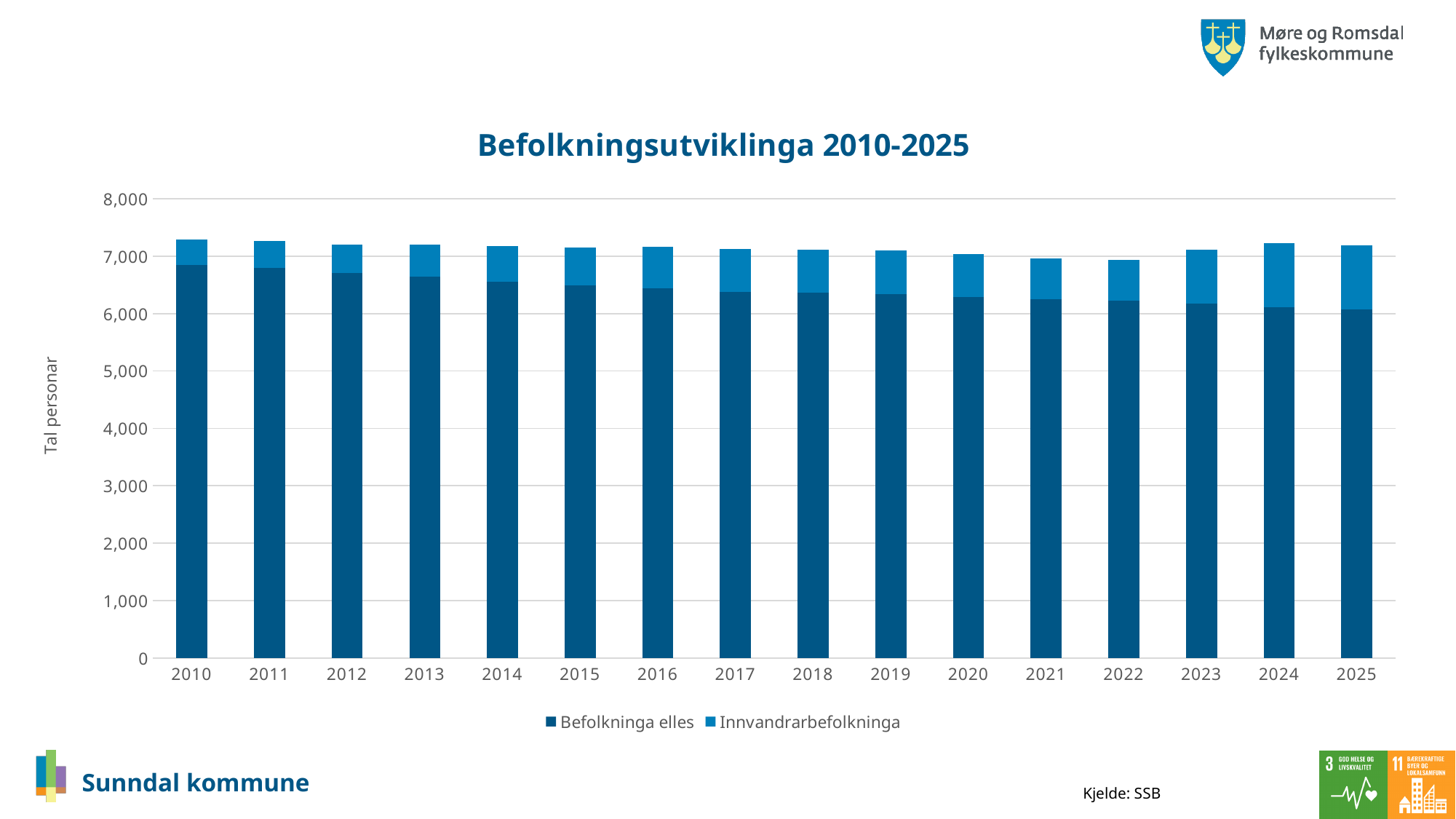
What is the title of the chart? Befolkningsutviklinga 2010-2025 Does the Innvandrarbefolkninga series rise or fall from 2010 to 2025? rise Is the Innvandrarbefolkninga segment for 2010 greater or less than 1,000? less Is the total bar height for 2010 greater or less than 7,000? greater What is the label on the vertical axis? Tal personar Which year has the larger Befolkninga elles value, 2010 or 2025? 2010 Which year has the larger Innvandrarbefolkninga value, 2010 or 2025? 2025 Does the Befolkninga elles series rise or fall from 2010 to 2025? fall How many years are shown along the x axis? 16 Is the value of Befolkninga elles for 2010 greater or less than 6,000? greater How many series does the legend list? 2 What kind of chart is shown on the slide? bar chart